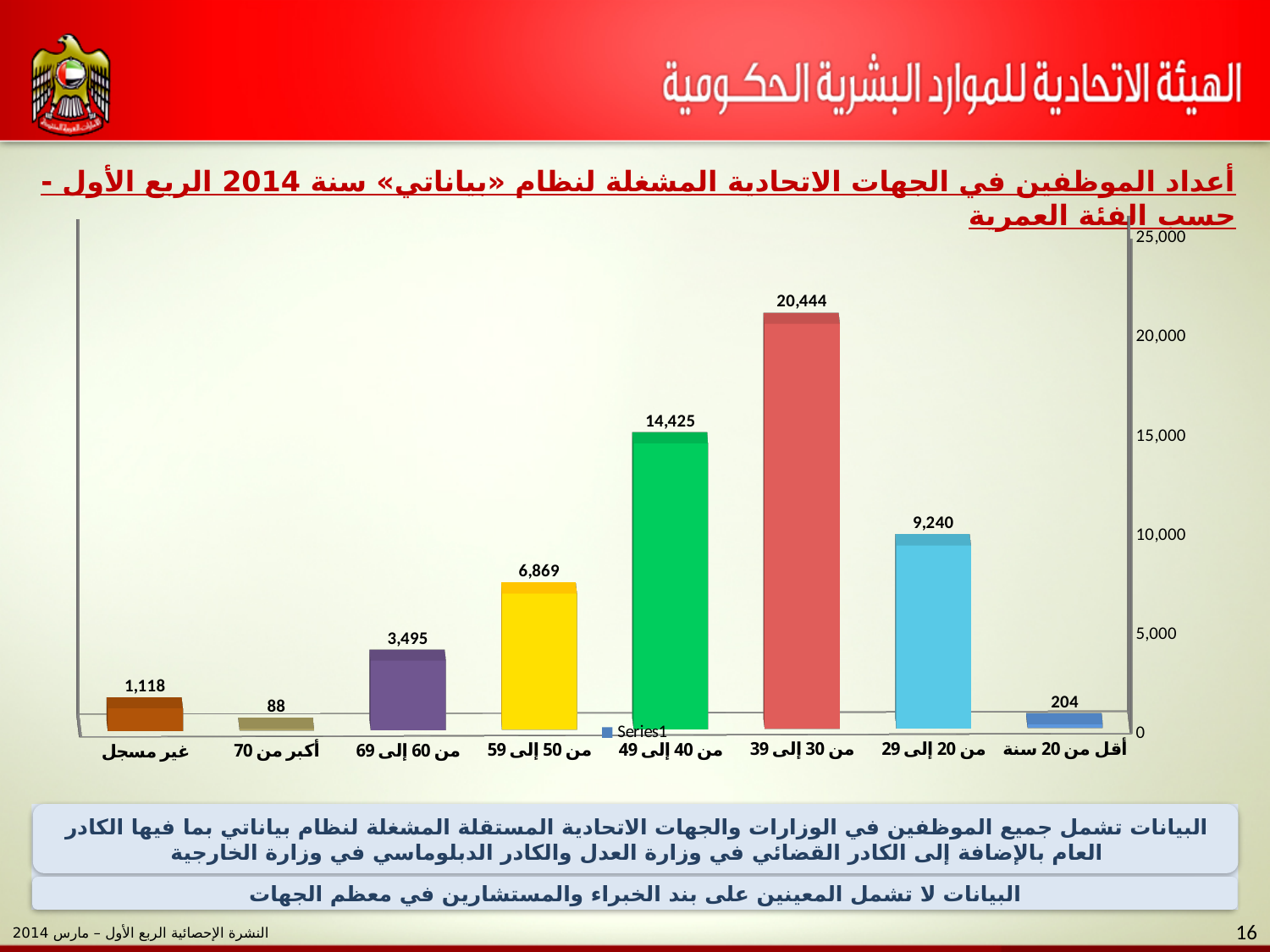
What is the value for the age group من 30 إلى 39? 20,444 What kind of chart is shown on the slide? bar chart Which age group has the highest number of employees? من 30 إلى 39 What is the name of the series shown in the legend? Series1 What is the difference between the values for من 30 إلى 39 and من 40 إلى 49? 6,019 What is the value for the category غير مسجل? 1,118 Is the value for من 40 إلى 49 greater or less than 10,000? greater How many categories are shown on the x axis? 8 Which category has the lowest value? أكبر من 70 Which is larger, the value for من 50 إلى 59 or the value for من 60 إلى 69? من 50 إلى 59 What is the value for the age group من 20 إلى 29? 9,240 How many series does the legend list? 1